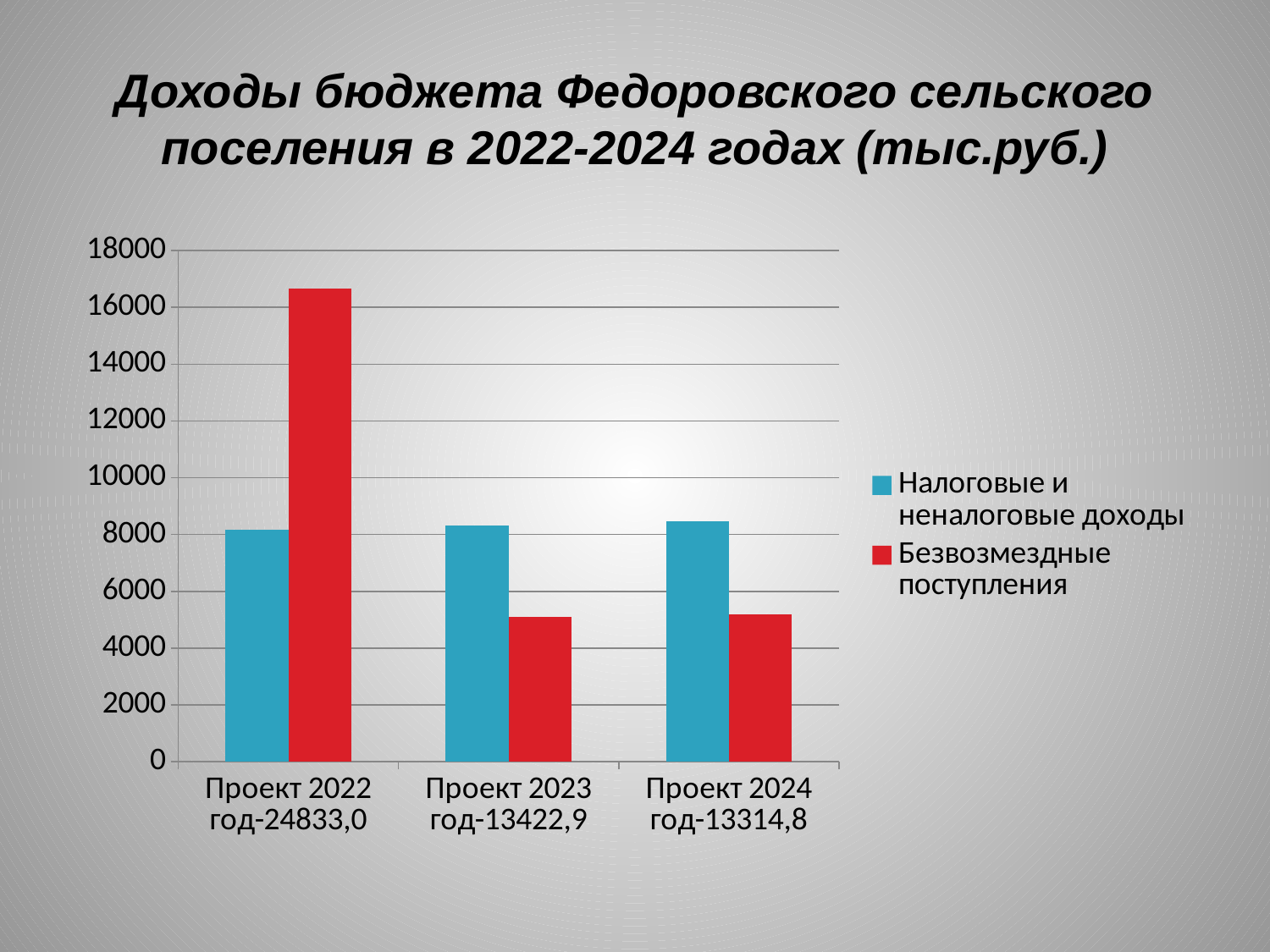
Which series is shown in red in the legend? Безвозмездные поступления Is the value for Безвозмездные поступления in Проект 2023 год-13422,9 greater or less than 6000? less For Проект 2023 год-13422,9, which series has the larger value: Налоговые и неналоговые доходы or Безвозмездные поступления? Налоговые и неналоговые доходы How many categories are shown on the x axis? 3 How many series does the legend list? 2 Is the value for Налоговые и неналоговые доходы in Проект 2022 год-24833,0 greater or less than 10000? less What kind of chart is shown on the slide? bar chart In which category is the value for Безвозмездные поступления highest? Проект 2022 год-24833,0 For Проект 2022 год-24833,0, which series has the larger value: Налоговые и неналоговые доходы or Безвозмездные поступления? Безвозмездные поступления Is the value for Налоговые и неналоговые доходы in Проект 2024 год-13314,8 greater or less than 8000? greater What is the title of the chart on the slide? Доходы бюджета Федоровского сельского поселения в 2022-2024 годах (тыс.руб.)